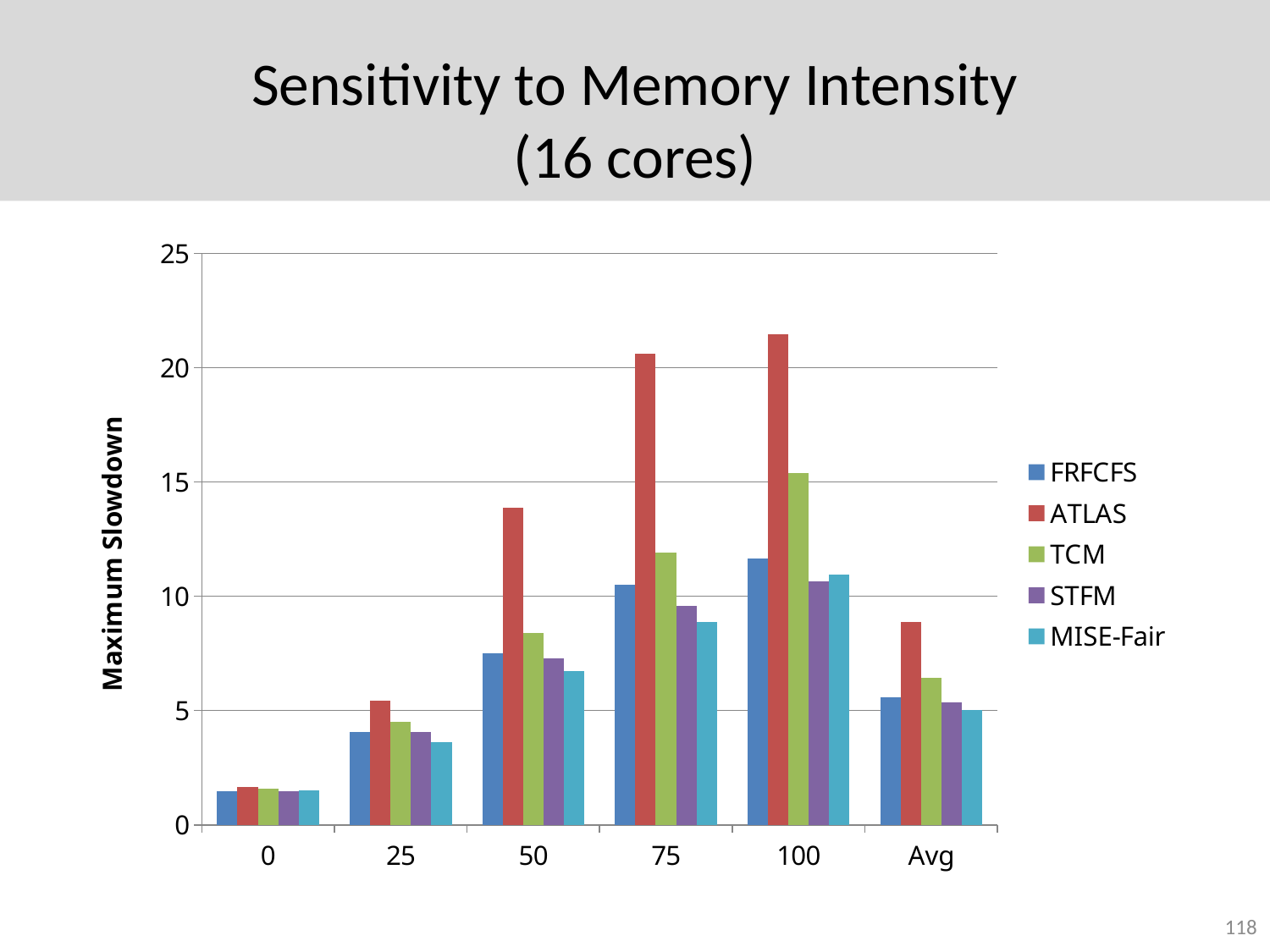
Which series has the highest maximum slowdown at memory intensity 75? ATLAS What kind of chart is shown on the slide? bar chart At memory intensity 100, which is larger: TCM or FRFCFS? TCM Is the value for ATLAS at memory intensity 100 greater or less than 20? greater In the Avg category, which is larger: ATLAS or TCM? ATLAS How many categories are shown along the x axis? 6 How many series does the legend list? 5 What is the label on the y axis? Maximum Slowdown Is the value for FRFCFS at memory intensity 100 greater or less than 10? greater Is the value for ATLAS at memory intensity 50 greater or less than 15? less Which series has the lowest maximum slowdown at memory intensity 75? MISE-Fair Does the maximum slowdown for ATLAS rise or fall as memory intensity goes from 0 to 100? rise